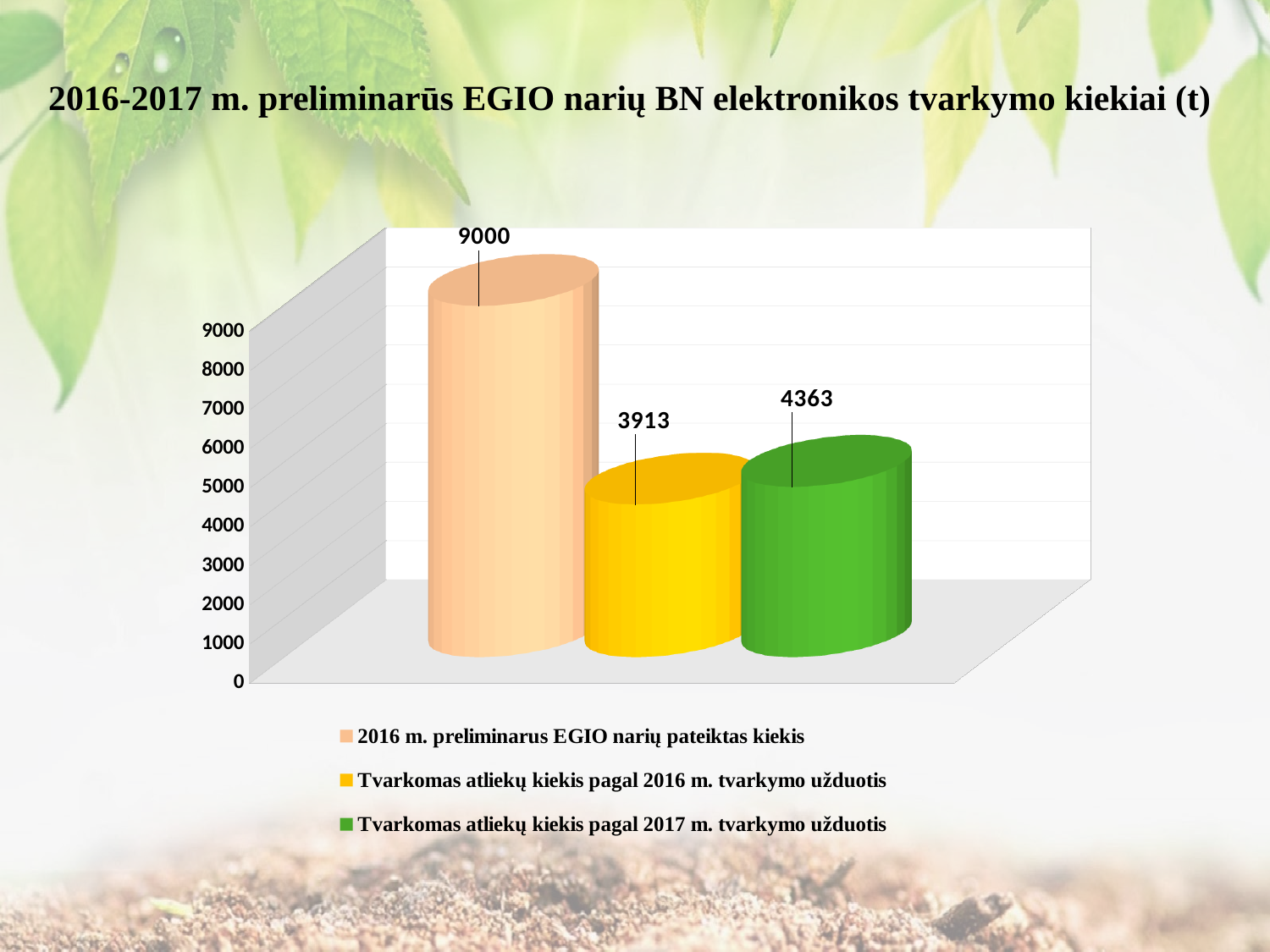
What is the difference between the 2016 m. preliminarus pateiktas kiekis value and the 2017 m. tvarkymo užduotis value? 4637 What is the title of the chart on the slide? 2016-2017 m. preliminarūs EGIO narių BN elektronikos tvarkymo kiekiai (t) What is the value for 'Tvarkomas atliekų kiekis pagal 2017 m. tvarkymo užduotis'? 4363 What kind of chart is shown on the slide? Bar chart Which is larger: the value for 2016 m. tvarkymo užduotis or the value for 2017 m. tvarkymo užduotis? Tvarkomas atliekų kiekis pagal 2017 m. tvarkymo užduotis What is the difference between the 2017 m. tvarkymo užduotis value and the 2016 m. tvarkymo užduotis value? 450 Which series has the highest value? 2016 m. preliminarus EGIO narių pateiktas kiekis What is the value for 'Tvarkomas atliekų kiekis pagal 2016 m. tvarkymo užduotis'? 3913 Which series has the lowest value? Tvarkomas atliekų kiekis pagal 2016 m. tvarkymo užduotis How many series does the legend list? 3 How many bars are plotted on the chart? 3 What is the value for '2016 m. preliminarus EGIO narių pateiktas kiekis'? 9000